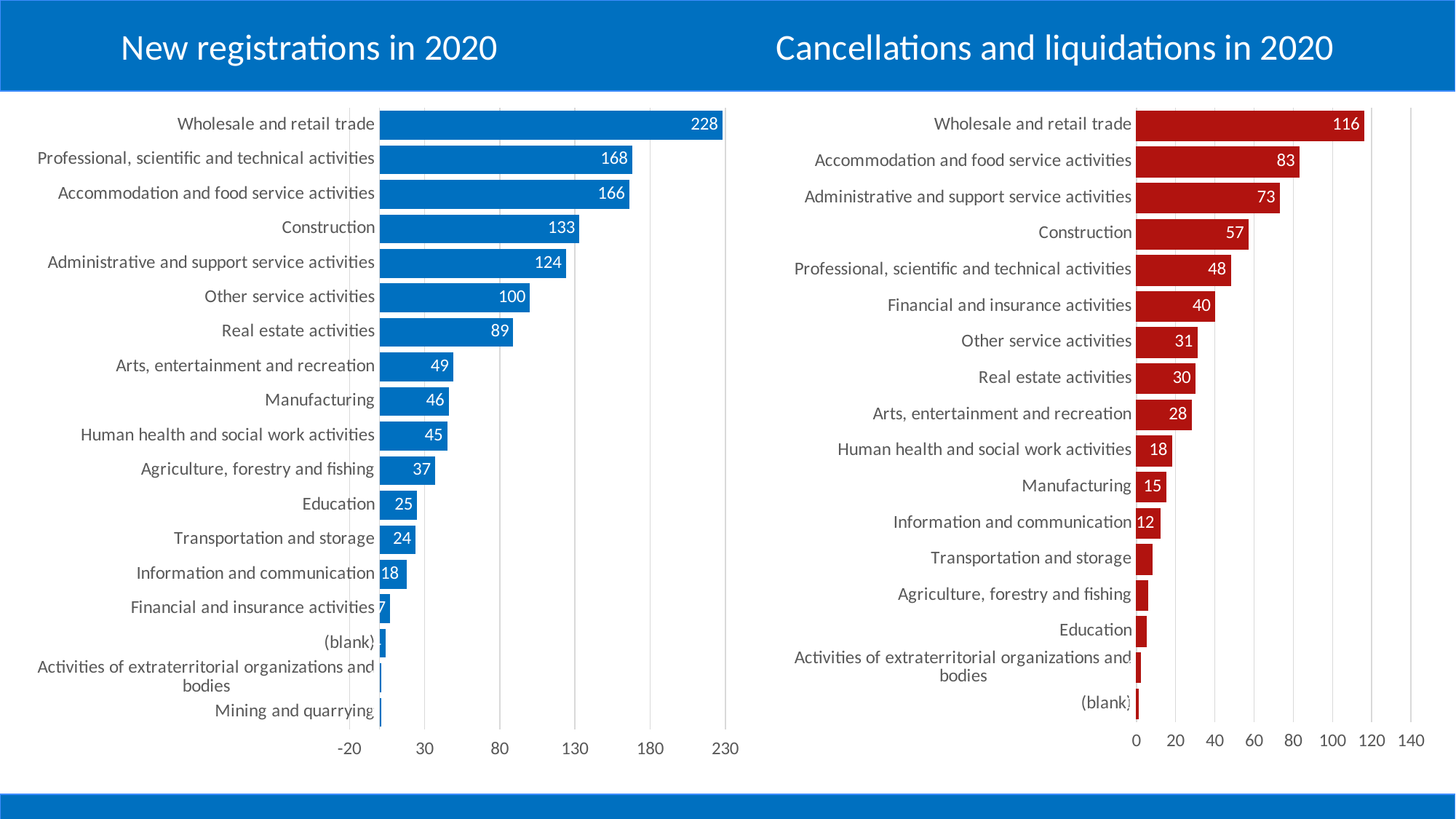
In the 'New registrations in 2020' chart, which is larger: Real estate activities or Arts, entertainment and recreation? Real estate activities In the 'Cancellations and liquidations in 2020' chart, what is the value for Financial and insurance activities? 40 In the 'New registrations in 2020' chart, what is the value for Construction? 133 In the 'Cancellations and liquidations in 2020' chart, what is the value for Accommodation and food service activities? 83 In the 'Cancellations and liquidations in 2020' chart, what is the difference between Wholesale and retail trade and Construction? 59 In the 'New registrations in 2020' chart, what is the difference between Professional, scientific and technical activities and Accommodation and food service activities? 2 What type of chart is the 'Cancellations and liquidations in 2020' chart? Bar chart In the 'Cancellations and liquidations in 2020' chart, is the value for Transportation and storage greater or less than 20? less In the 'New registrations in 2020' chart, what is the value for Wholesale and retail trade? 228 How many categories are shown in the 'New registrations in 2020' chart? 18 How many categories are shown in the 'Cancellations and liquidations in 2020' chart? 17 In the 'Cancellations and liquidations in 2020' chart, which category has the highest value? Wholesale and retail trade